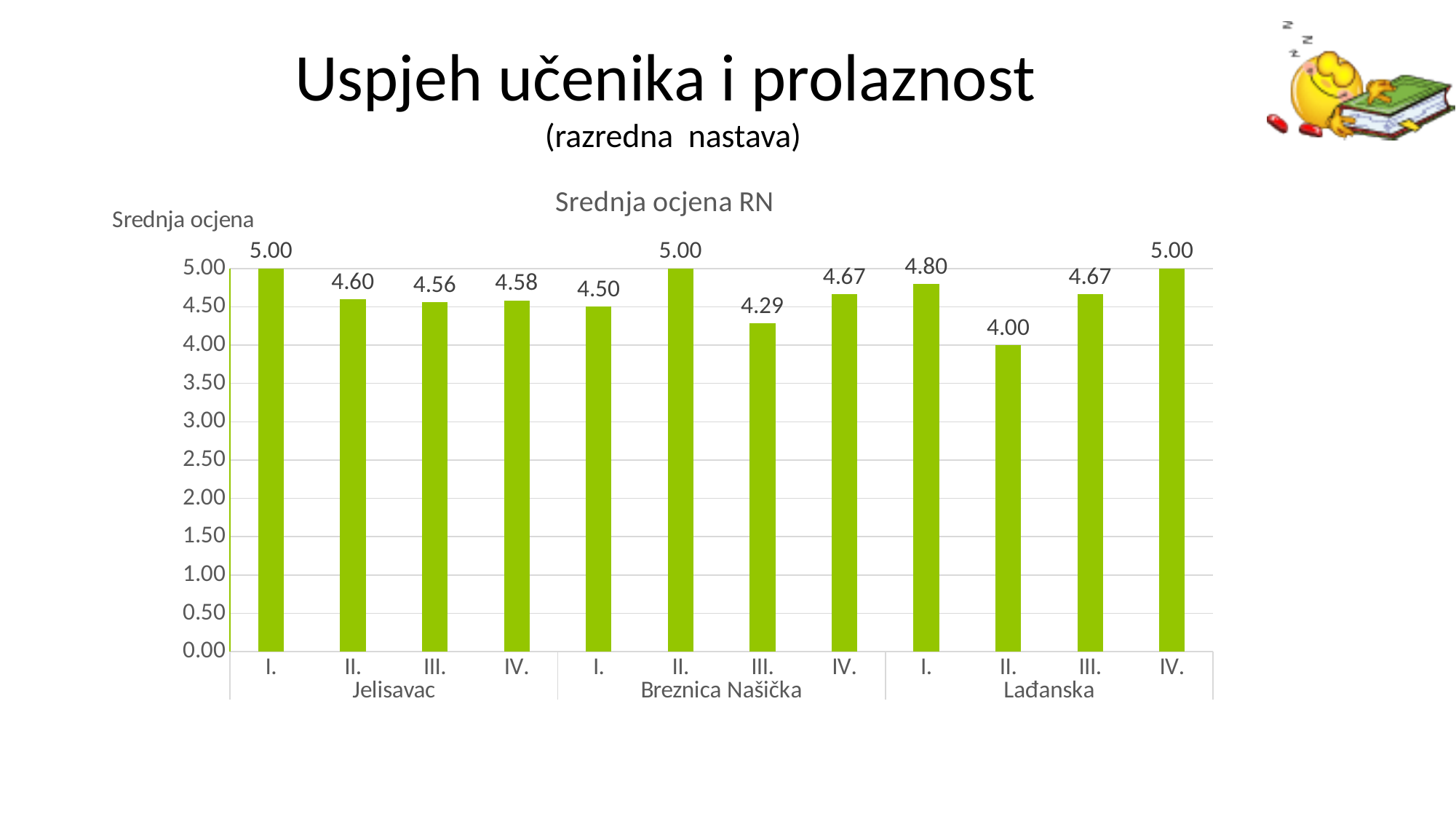
What type of chart is shown on the slide? bar chart What is the value shown for class I. in Lađanska? 4.80 Which class has the lowest average grade on the chart? II. Lađanska How many bars are plotted on the chart? 12 What is the value shown for class III. in Breznica Našička? 4.29 What is the title of the chart? Srednja ocjena RN Which is larger: class IV. in Jelisavac or class IV. in Breznica Našička? IV. Breznica Našička Is the value for class III. in Breznica Našička greater or less than 4.50? less What is the average grade (srednja ocjena) for class II. in Jelisavac? 4.60 What is the difference between class II. and class III. in Breznica Našička? 0.71 What is the difference between the values for class I. and class II. in Lađanska? 0.80 Within Jelisavac, which class has the lowest average grade? III.